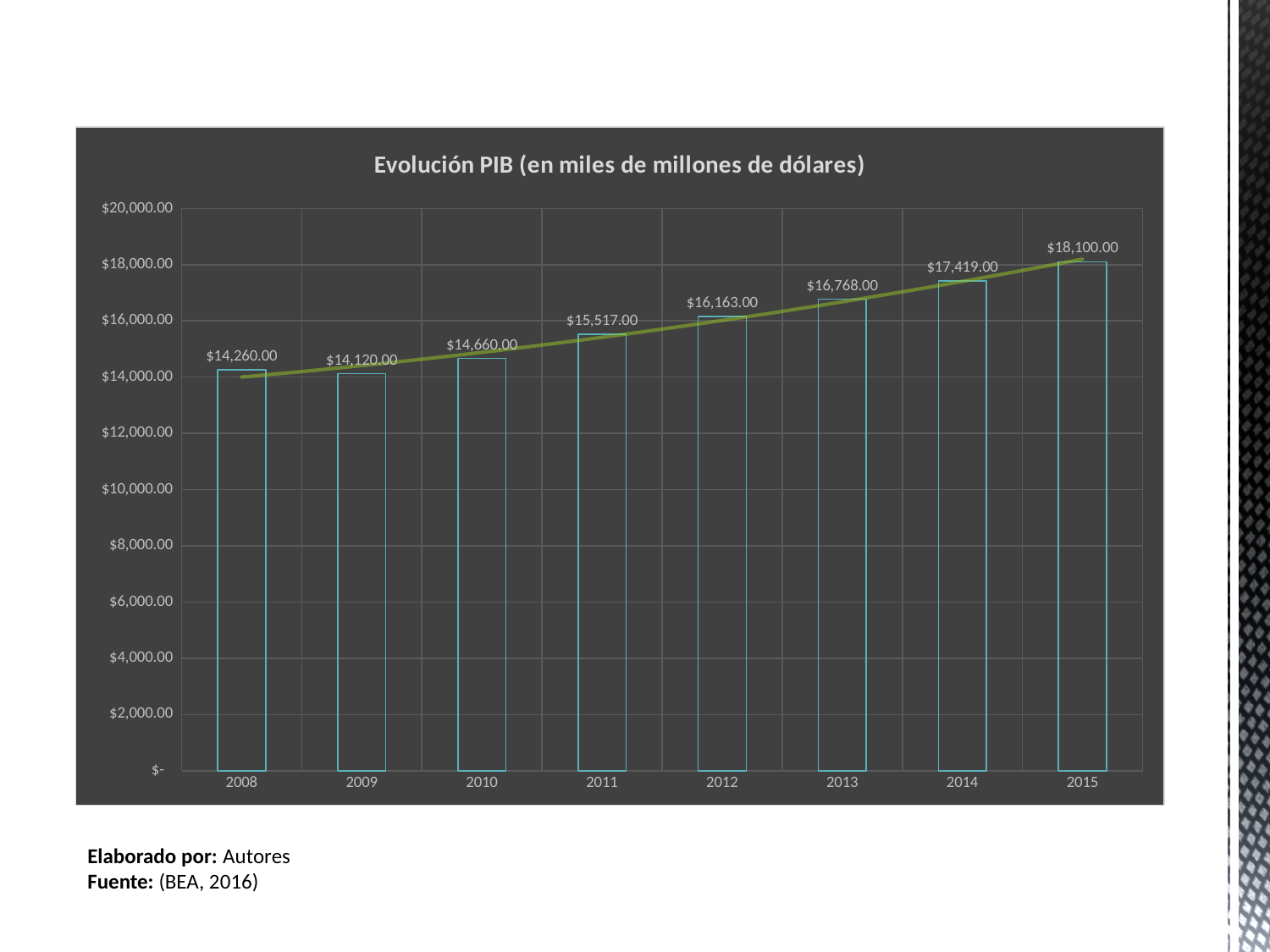
Is the value for 2013 greater or less than $16,000.00? greater Which is larger, the value for 2010 or the value for 2011? 2011 What is the value for 2012? $16,163.00 Which year has the highest value? 2015 What is the difference between the values for 2015 and 2008? $3,840.00 What is the title of the chart? Evolución PIB (en miles de millones de dólares) How many years are shown on the x axis? 8 What is the value for 2015? $18,100.00 What is the difference between the values for 2014 and 2013? $651.00 What kind of chart is this? bar chart Which year has the lowest value? 2009 What is the value for 2008? $14,260.00